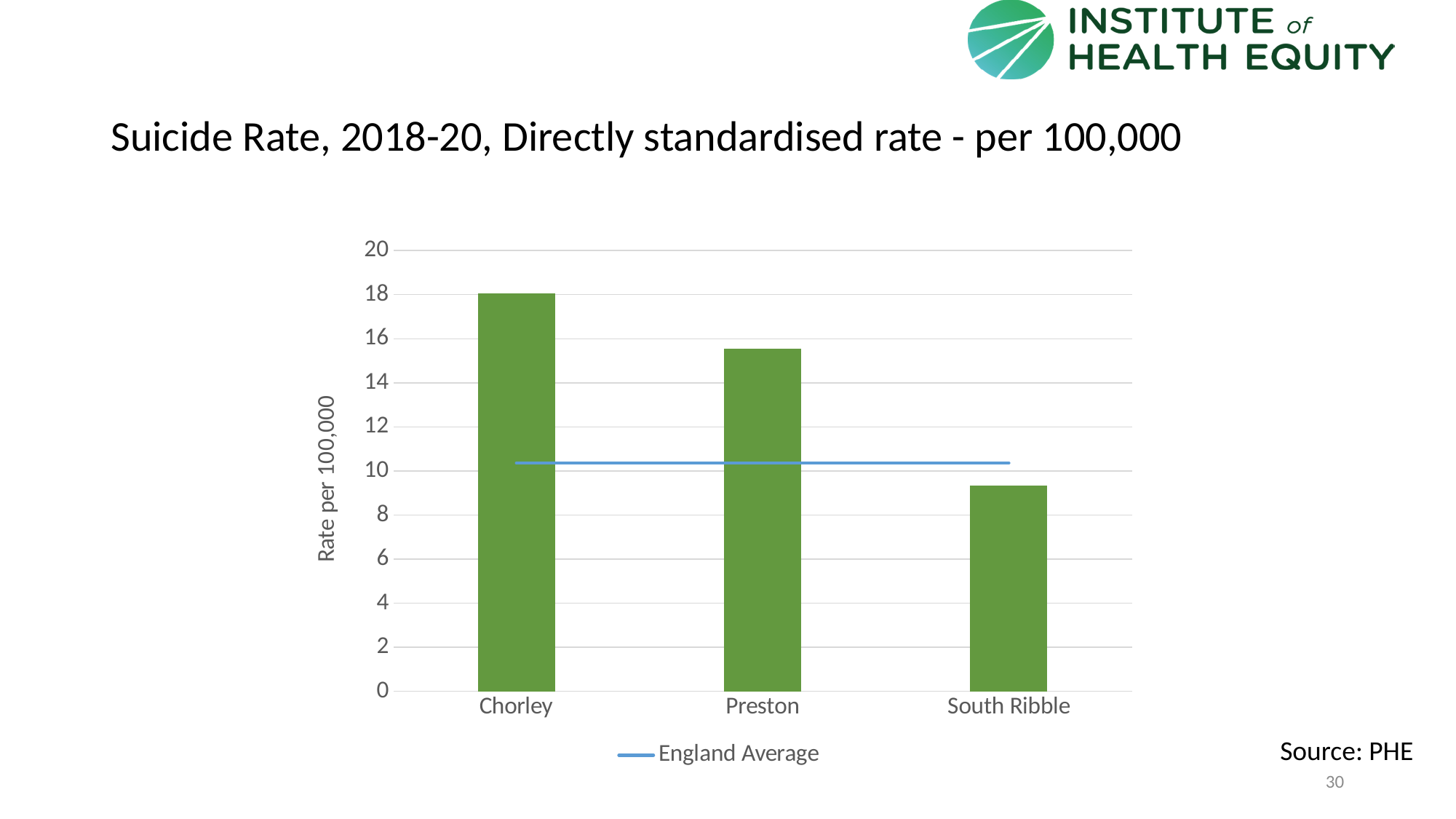
Do the bar values rise or fall from left to right across the x axis? fall What kind of chart is shown on the slide? bar chart How many entries does the legend list? 1 What is the label on the y axis? Rate per 100,000 Which area has the highest suicide rate? Chorley Is the value for Preston greater or less than 14? greater Is the value for Chorley greater or less than 16? greater How many areas (categories) are plotted on the x axis? 3 Which area has the lowest suicide rate? South Ribble Is the South Ribble bar above or below the England Average line? below Is the value for South Ribble greater or less than 10? less Which has the higher suicide rate, Chorley or Preston? Chorley